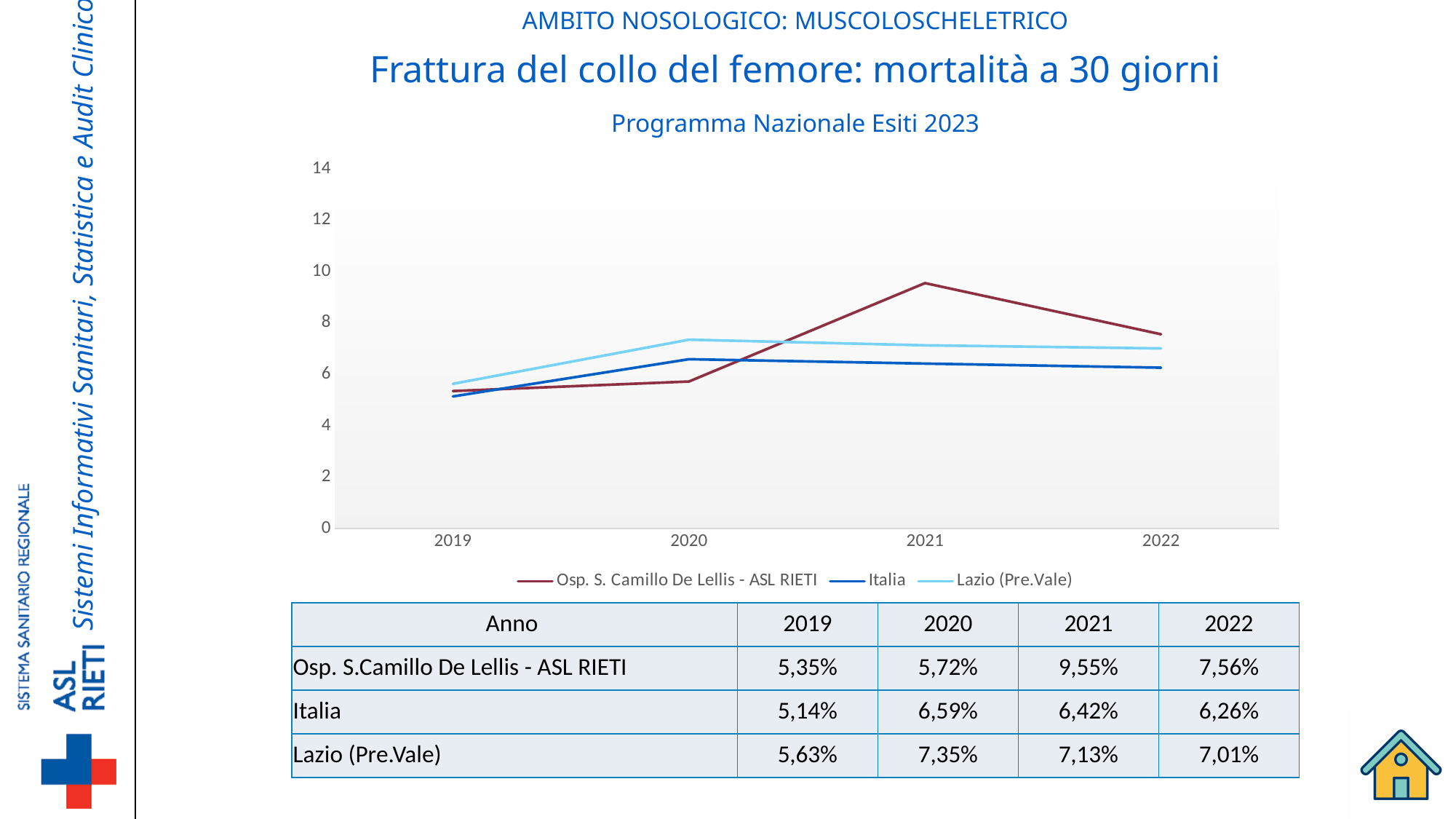
In which year does Italia have its lowest value? 2019 What type of chart is shown on the slide? line chart Does the value for Italia rise or fall from 2020 to 2022? fall How many series does the chart legend list? 3 What is the difference between the 2021 values for Osp. S. Camillo De Lellis - ASL RIETI and Italia? 3,13% Which is larger in 2020: the value for Lazio (Pre.Vale) or the value for Osp. S. Camillo De Lellis - ASL RIETI? Lazio (Pre.Vale) In which year does Osp. S. Camillo De Lellis - ASL RIETI reach its highest value? 2021 How many years are plotted along the x axis of the chart? 4 What is the value for Italia in 2020? 6,59% What is the value for Lazio (Pre.Vale) in 2022? 7,01% Is the value for Osp. S. Camillo De Lellis - ASL RIETI in 2021 greater or less than 8? greater What is the value for Osp. S. Camillo De Lellis - ASL RIETI in 2021? 9,55%